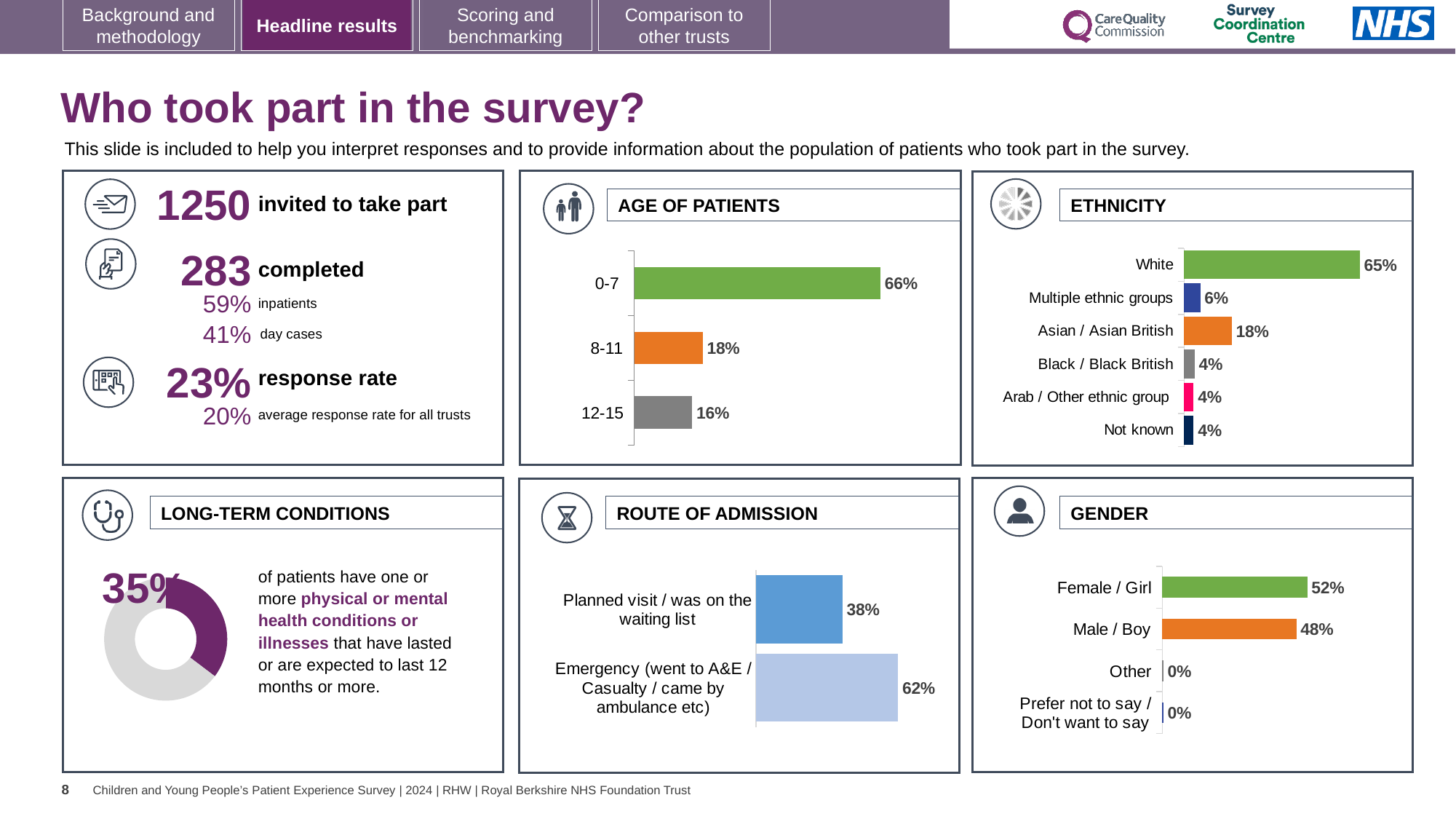
In the ROUTE OF ADMISSION chart, what is the difference between the Emergency and Planned visit percentages? 24% In the AGE OF PATIENTS chart, what is the difference between the 0-7 and 8-11 percentages? 48% In the AGE OF PATIENTS chart, which age group has the lowest percentage? 12-15 In the ETHNICITY chart, what percentage of patients are Asian / Asian British? 18% What kind of chart is used in the LONG-TERM CONDITIONS panel? Doughnut chart In the GENDER chart, what percentage of patients are Male / Boy? 48% In the ETHNICITY chart, which category has the highest percentage? White In the AGE OF PATIENTS chart, what percentage of patients are aged 0-7? 66% In the ETHNICITY chart, which is larger: Multiple ethnic groups or Black / Black British? Multiple ethnic groups In the ROUTE OF ADMISSION chart, what percentage of patients came via Emergency (went to A&E / Casualty / came by ambulance etc)? 62% How many categories are shown in the ETHNICITY chart? 6 In the GENDER chart, which category has the highest percentage? Female / Girl